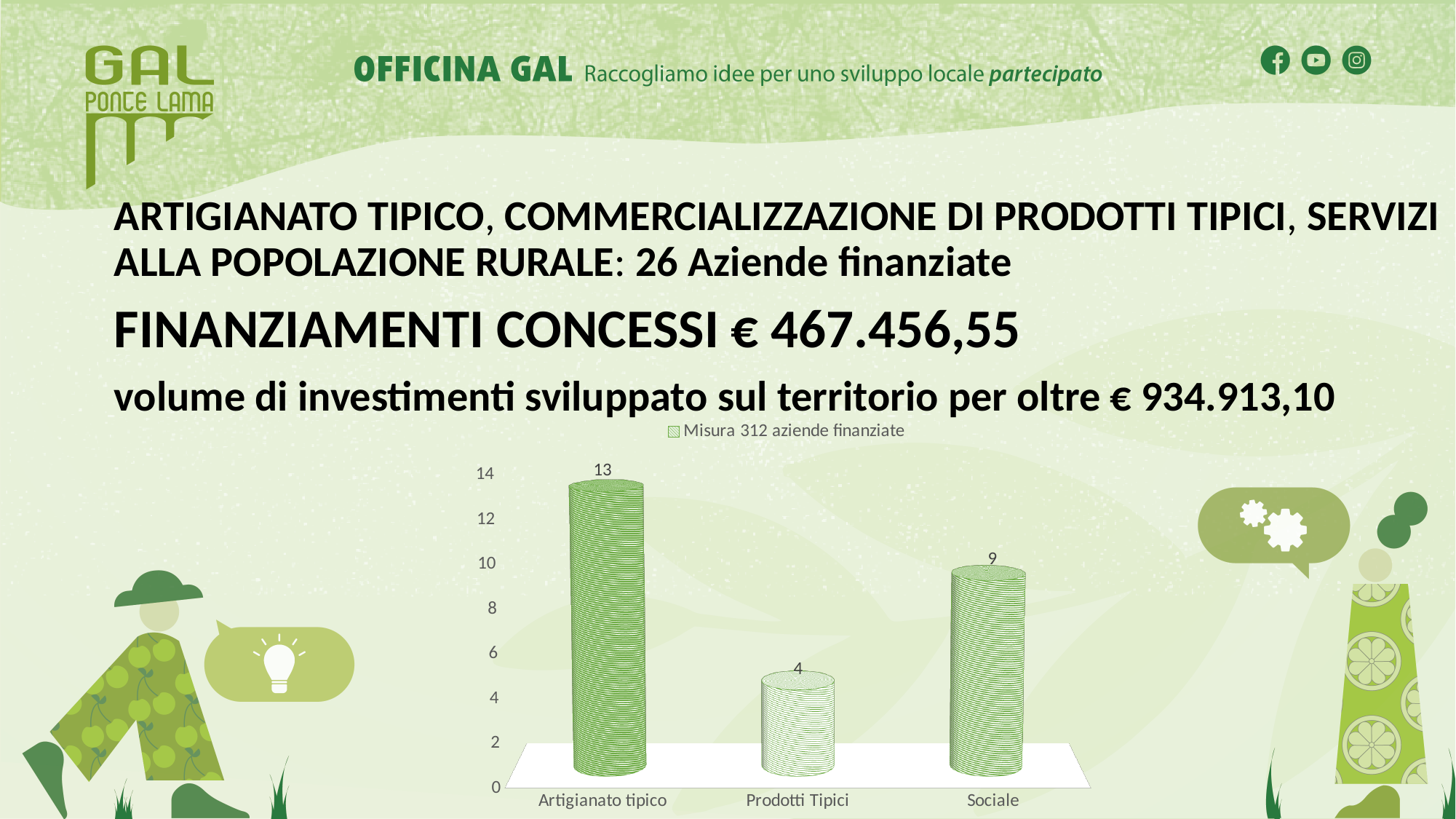
How many series does the legend list? 1 Which category has the lowest value? Prodotti Tipici What is the value for Prodotti Tipici? 4 What kind of chart is shown on the slide? Bar chart What is the difference between the values for Sociale and Prodotti Tipici? 5 What is the value for Artigianato tipico? 13 What is the legend entry of the chart? Misura 312 aziende finanziate Which category has the highest value? Artigianato tipico What is the value for Sociale? 9 What is the difference between the values for Artigianato tipico and Sociale? 4 How many categories are shown on the x axis? 3 Which is larger, the value for Sociale or the value for Prodotti Tipici? Sociale